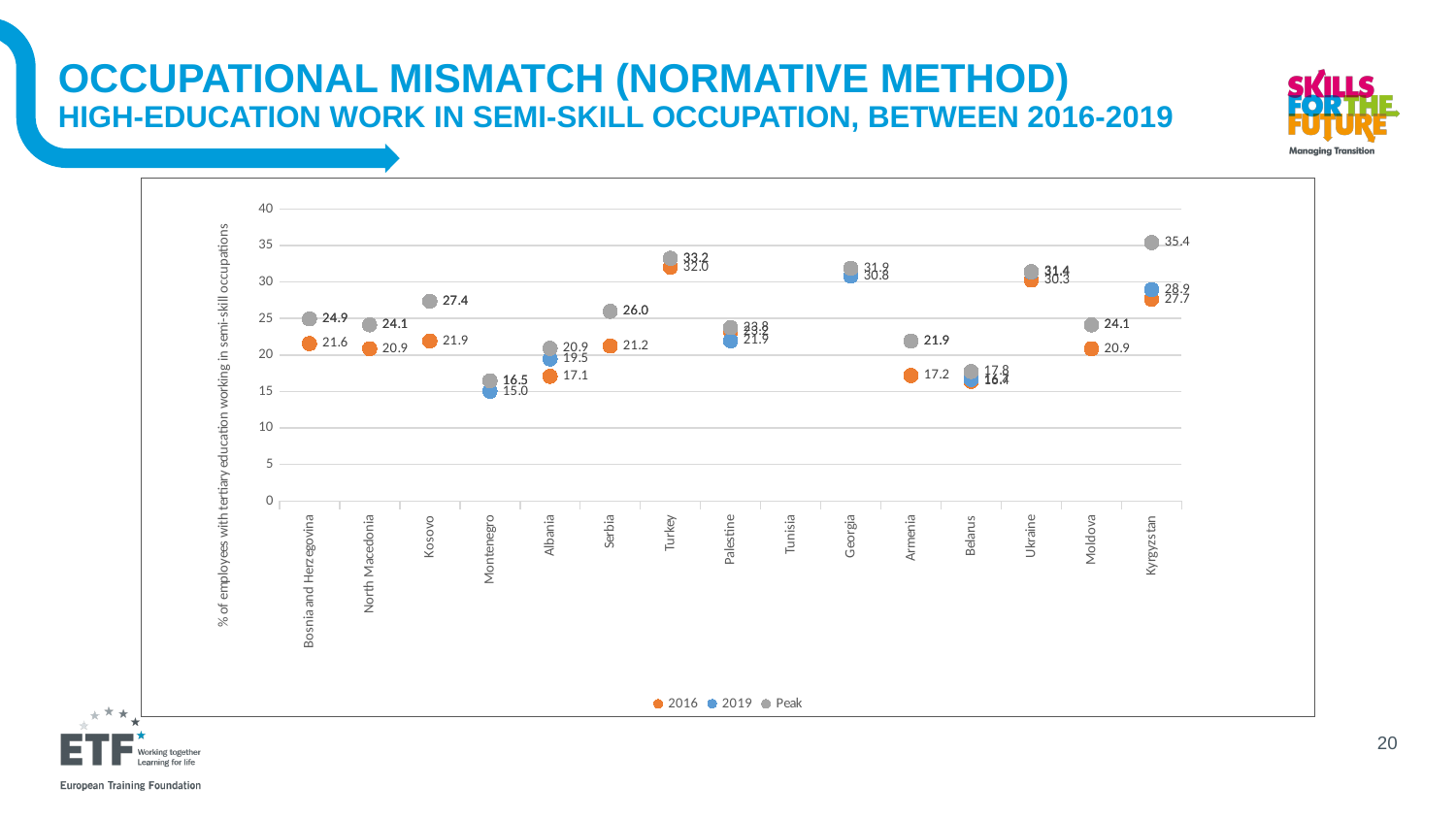
Which country has the highest Peak value? Kyrgyzstan What is the title of the vertical axis? % of employees with tertiary education working in semi-skill occupations How many series does the legend list? 3 How many countries are shown on the x axis? 15 What kind of chart is shown on the slide? scatter chart Is the 2016 value for Armenia greater or less than 20? less Which has the higher Peak value, Kosovo or Serbia? Kosovo What is the 2016 value for Albania? 17.1 What is the difference between the Peak value and the 2016 value for Bosnia and Herzegovina? 3.3 What is the Peak value for Kosovo? 27.4 What is the Peak value for Kyrgyzstan? 35.4 Which country has the lowest 2019 value? Montenegro